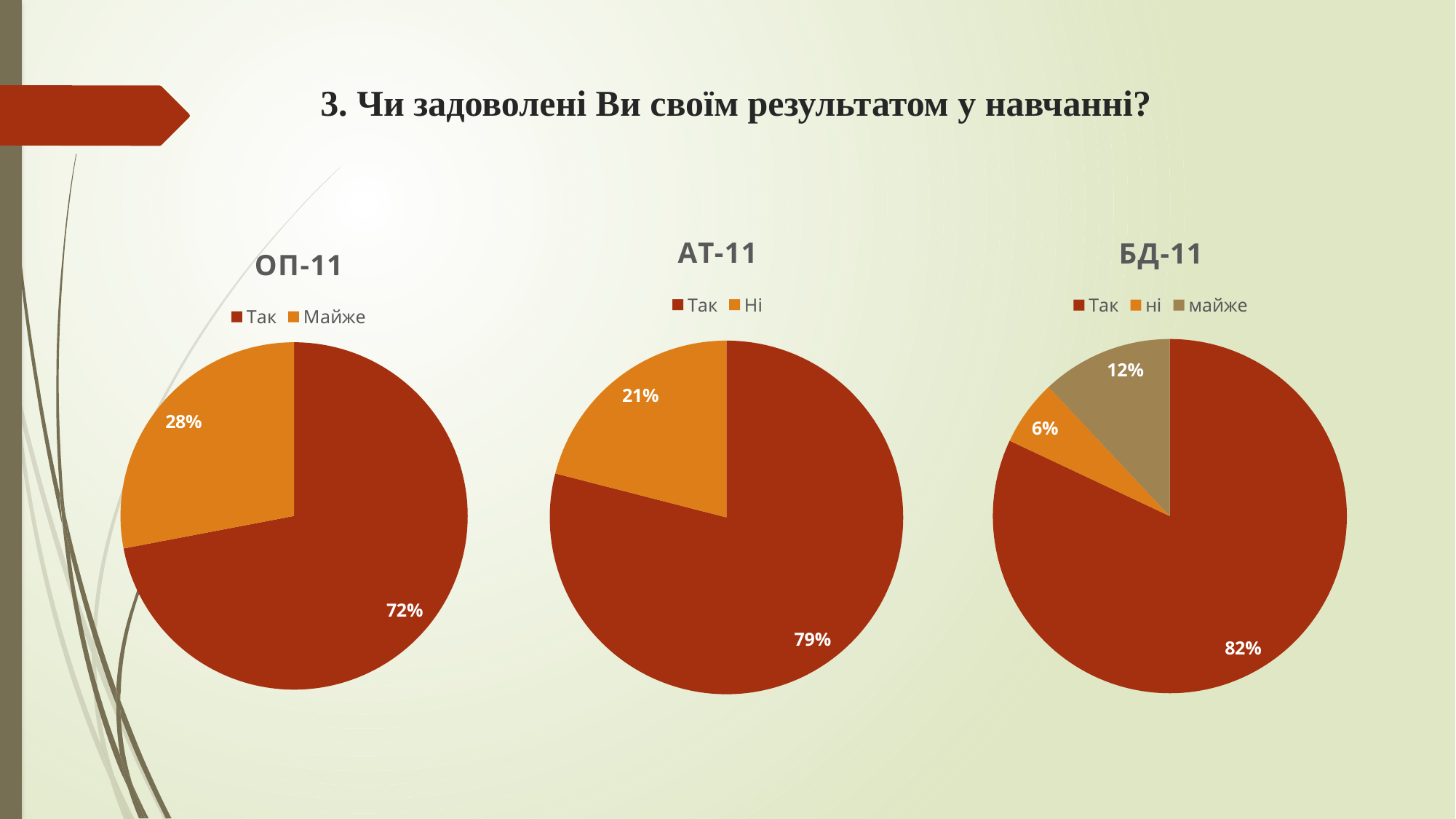
How many categories does the legend of the БД-11 chart list? 3 In the БД-11 chart, what is the difference between the Так slice and the майже slice? 70% In the БД-11 chart, what is the value for ні? 6% In the БД-11 chart, which is larger: the майже slice or the ні slice? майже In the ОП-11 chart, what share of the pie is labelled Майже? 28% In the БД-11 chart, which category has the smallest slice? ні In the БД-11 chart, what is the value for майже? 12% In the АТ-11 chart, what is the value for Ні? 21% In the АТ-11 chart, what is the value for Так? 79% What kind of chart is the АТ-11 chart? Pie chart In the БД-11 chart, which category has the largest slice? Так In the ОП-11 chart, what share of the pie is labelled Так? 72%